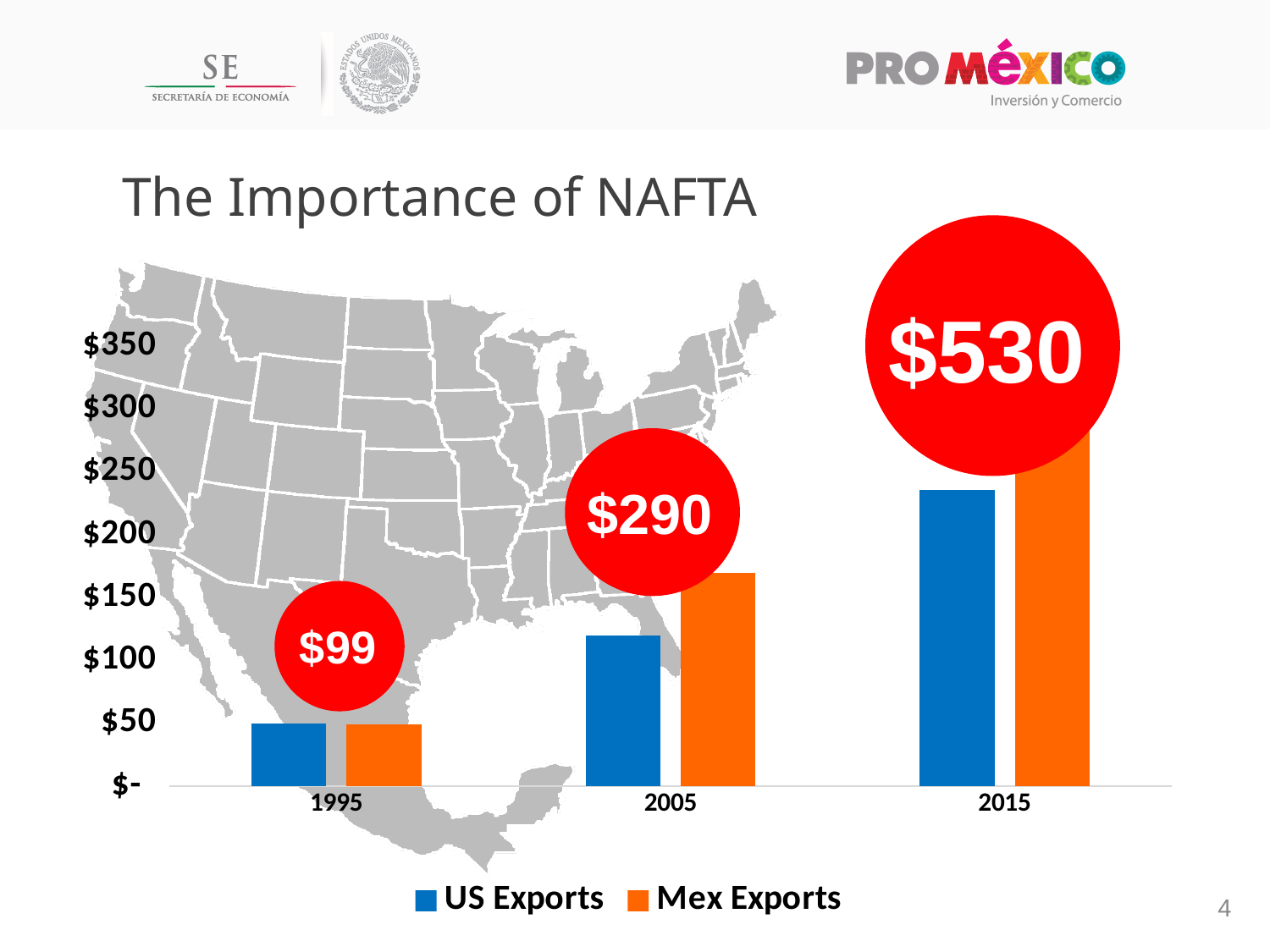
What value is printed in the red circle above the 2005 bars? $290 What value is printed in the red circle above the 2015 bars? $530 Which series is shown in orange in the chart? Mex Exports In 2015, which is larger, US Exports or Mex Exports? Mex Exports Is the value for Mex Exports in 2005 greater or less than $150? greater What is the title of the slide containing the chart? The Importance of NAFTA What kind of chart is shown on the slide? bar chart How many series does the chart legend list? 2 Is the value for US Exports in 2015 greater or less than $200? greater How many years are shown on the x axis of the chart? 3 Do US Exports rise or fall from 1995 to 2015? rise What value is printed in the red circle above the 1995 bars? $99